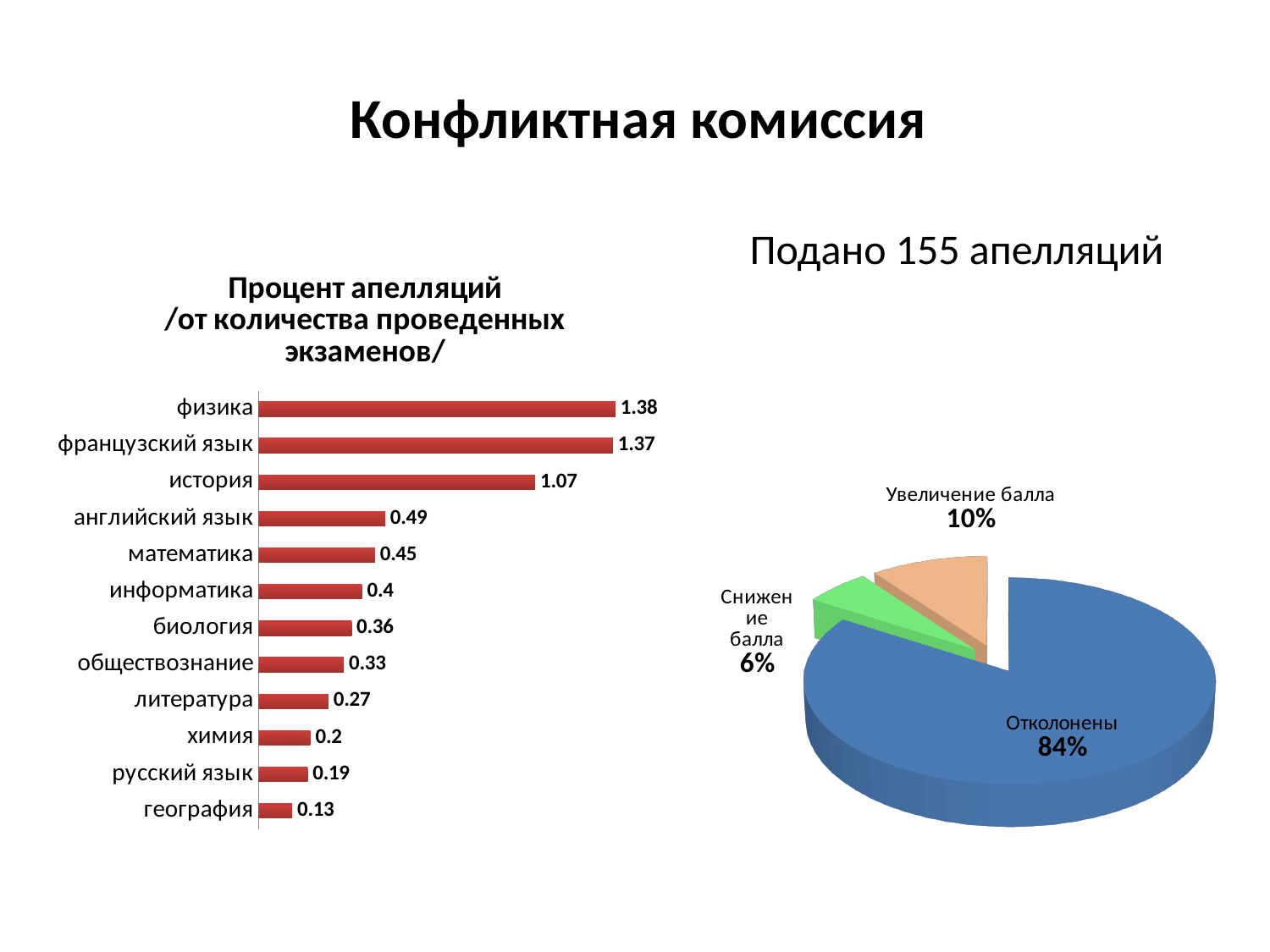
In the bar chart on the left, which subject has the highest value? физика How many slices does the pie chart on the right have? 3 How many subjects are shown in the bar chart on the left? 12 In the bar chart 'Процент апелляций /от количества проведенных экзаменов/', what is the value for история? 1.07 In the pie chart on the right, what share is labelled Снижение балла? 6% In the bar chart on the left, what is the difference between the values for физика and история? 0.31 In the bar chart on the left, which subject has the lowest value? география In the pie chart on the right, what share is labelled Отколонены? 84% What kind of chart is the chart on the left of the slide? bar chart What kind of chart is the chart on the right of the slide? pie chart In the bar chart on the left, which is larger: the value for английский язык or the value for биология? английский язык In the bar chart on the left, what is the value for математика? 0.45